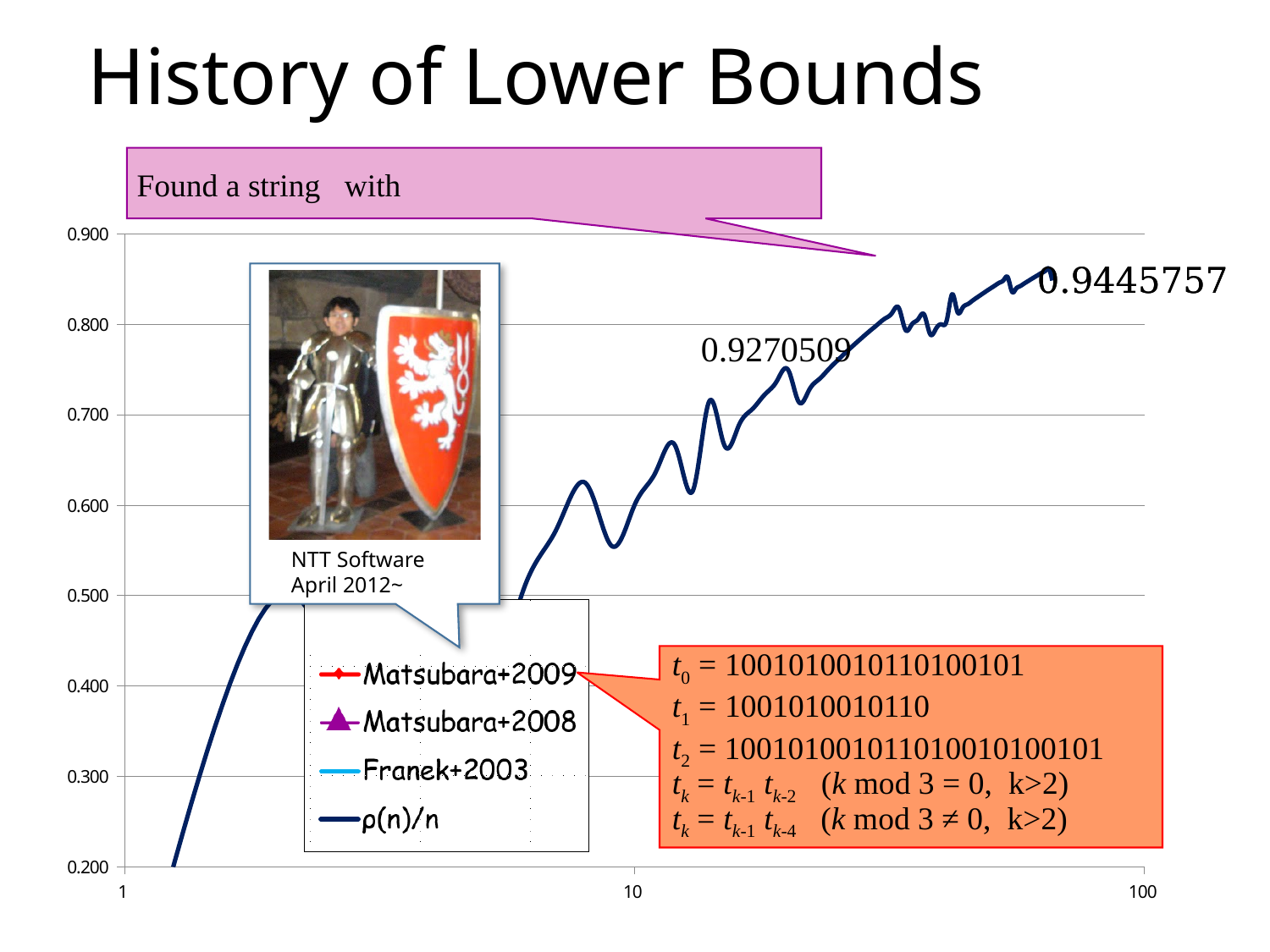
What is the highest tick value shown on the y axis? 0.900 How many series does the chart legend list? 4 What kind of chart is shown on the slide? line chart Which series is listed last in the chart legend? ρ(n)/n Does the ρ(n)/n line generally rise or fall as the x axis increases from 1 to 100? rise What is the title of the slide containing the chart? History of Lower Bounds